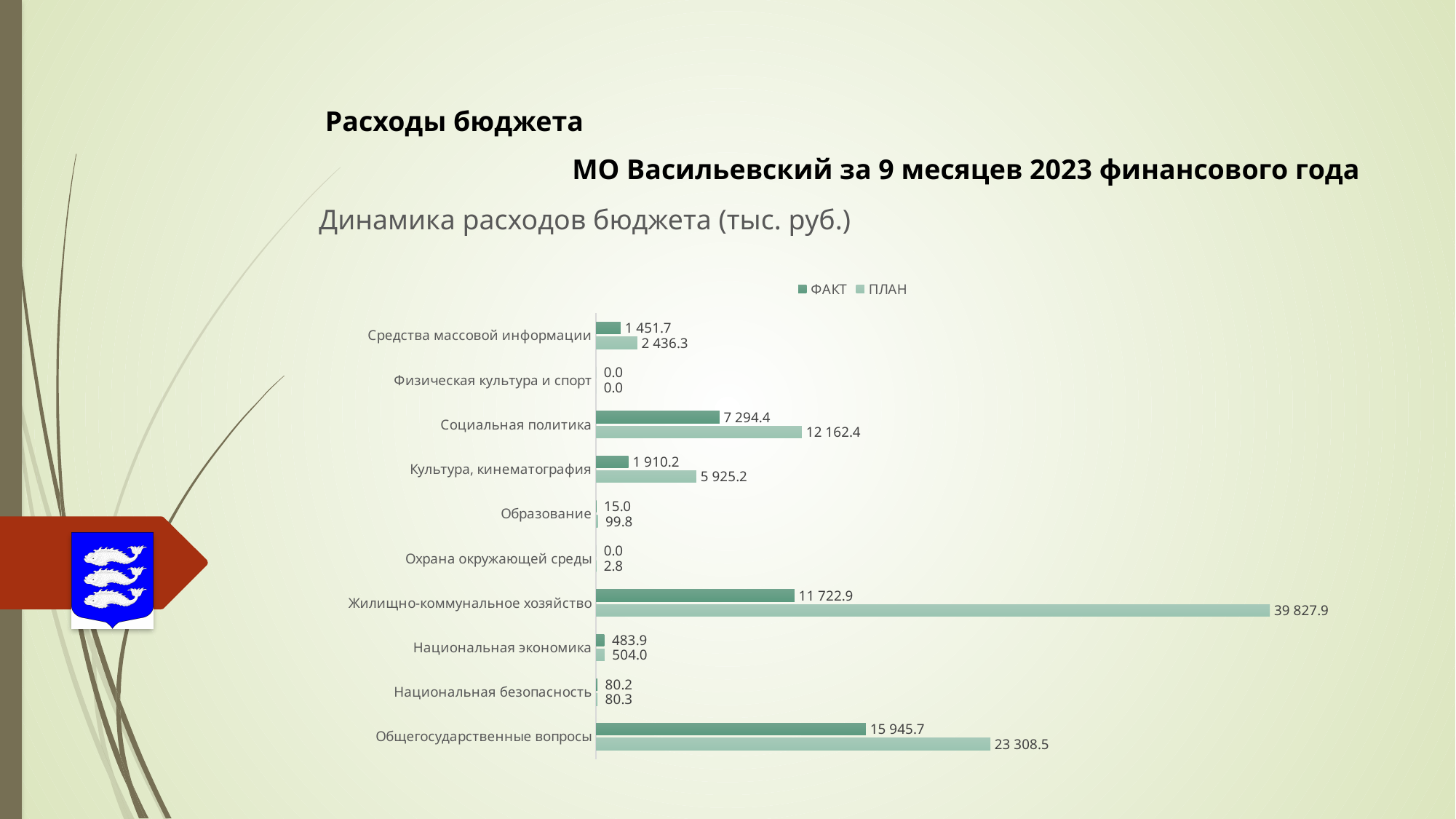
What type of chart is shown on the slide? bar chart What is the difference between the ПЛАН and ФАКТ values for Общегосударственные вопросы? 7 362.8 What are the two series named in the legend? ФАКТ and ПЛАН What is the ФАКТ value for Жилищно-коммунальное хозяйство? 11 722.9 Which is larger for Средства массовой информации, the ФАКТ value or the ПЛАН value? ПЛАН Which category has the highest ПЛАН value? Жилищно-коммунальное хозяйство What is the difference between the ПЛАН and ФАКТ values for Жилищно-коммунальное хозяйство? 28 105.0 Which category has the highest ФАКТ value? Общегосударственные вопросы How many categories are shown on the chart? 10 What is the ПЛАН value for Культура, кинематография? 5 925.2 How many series does the legend list? 2 What is the ПЛАН value for Социальная политика? 12 162.4